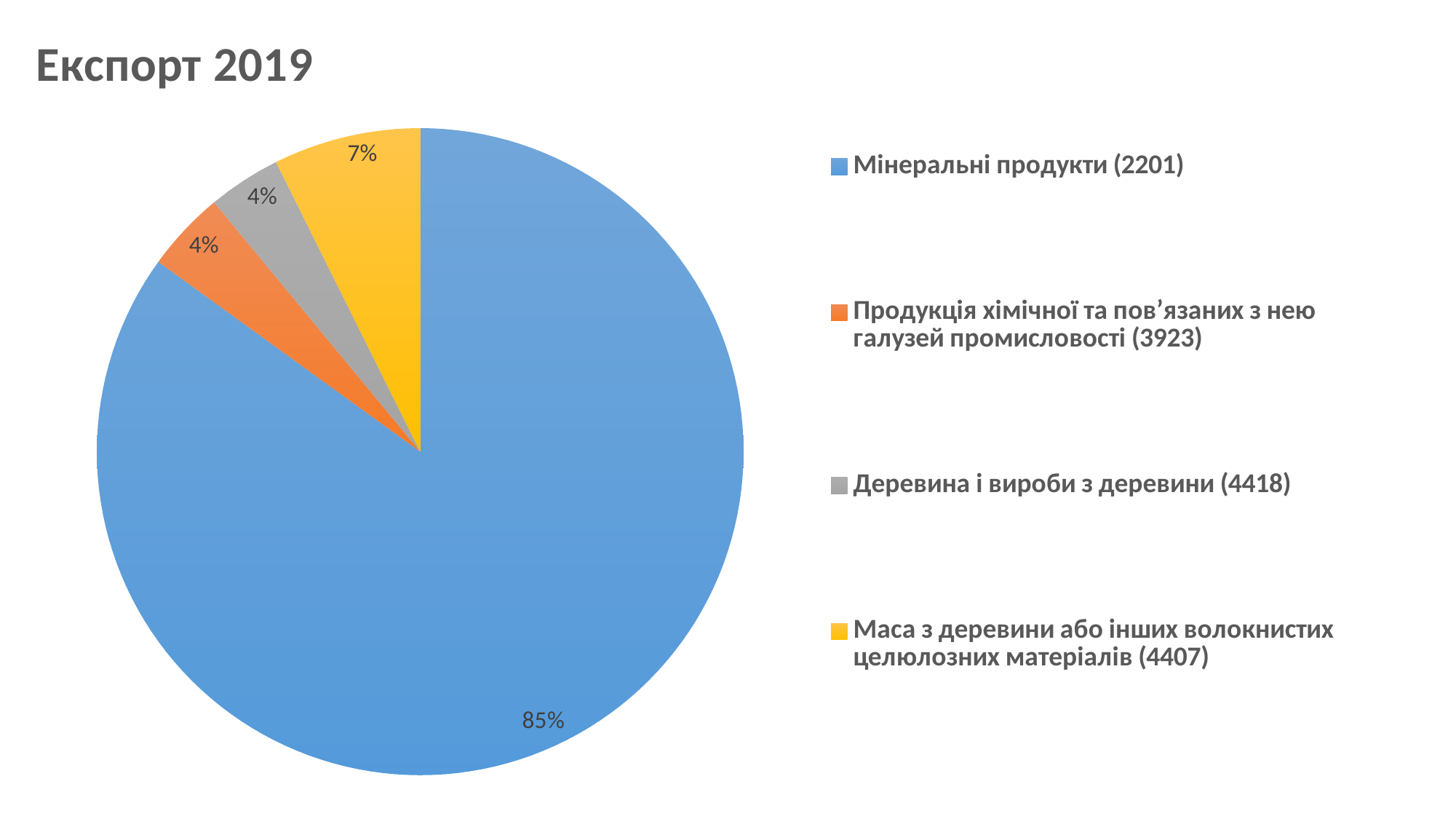
By how many percentage points does the share of Мінеральні продукти (2201) exceed the share of Маса з деревини або інших волокнистих целюлозних матеріалів (4407)? 78 What is the title of the chart? Експорт 2019 How many slices does the pie chart have? 4 Which is larger: the slice for Маса з деревини або інших волокнистих целюлозних матеріалів (4407) or the slice for Деревина і вироби з деревини (4418)? Маса з деревини або інших волокнистих целюлозних матеріалів (4407) What share of the pie does Деревина і вироби з деревини (4418) take? 4% What share of the pie does Маса з деревини або інших волокнистих целюлозних матеріалів (4407) take? 7% What share of the pie does Мінеральні продукти (2201) take? 85% Which category has the largest slice of the pie? Мінеральні продукти (2201) Which is larger: the slice for Мінеральні продукти (2201) or the slice for Маса з деревини або інших волокнистих целюлозних матеріалів (4407)? Мінеральні продукти (2201) What kind of chart is shown on the slide? pie chart What colour is the slice for Деревина і вироби з деревини (4418)? grey